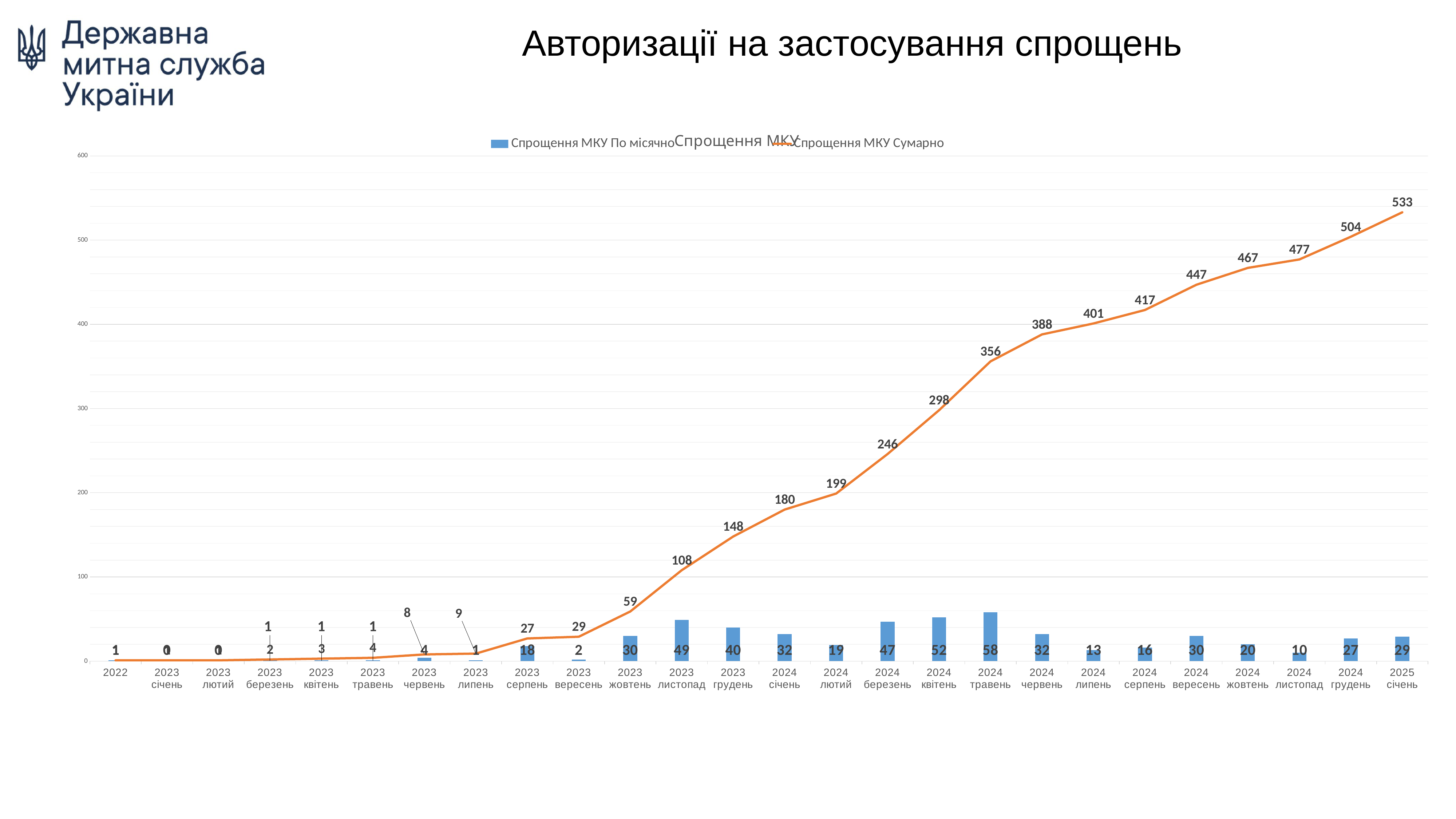
Is the cumulative value (Спрощення МКУ Сумарно) for 2024 червень greater or less than 300? greater Which is larger: the monthly value for 2023 листопад or for 2024 березень? 2023 листопад What colour is the line for Спрощення МКУ Сумарно? orange What is the difference between the cumulative values for 2024 грудень and 2024 листопад? 27 How many categories (time periods) are shown on the x axis? 26 Does the cumulative series (Спрощення МКУ Сумарно) rise or fall along the x axis? rise What is the monthly value (Спрощення МКУ По місячно) for 2024 травень? 58 What is the cumulative value (Спрощення МКУ Сумарно) for 2023 грудень? 148 What is the monthly value (Спрощення МКУ По місячно) for 2024 листопад? 10 What is the cumulative value (Спрощення МКУ Сумарно) for 2025 січень? 533 How many series does the legend list? 2 Which month has the highest monthly value (Спрощення МКУ По місячно)? 2024 травень